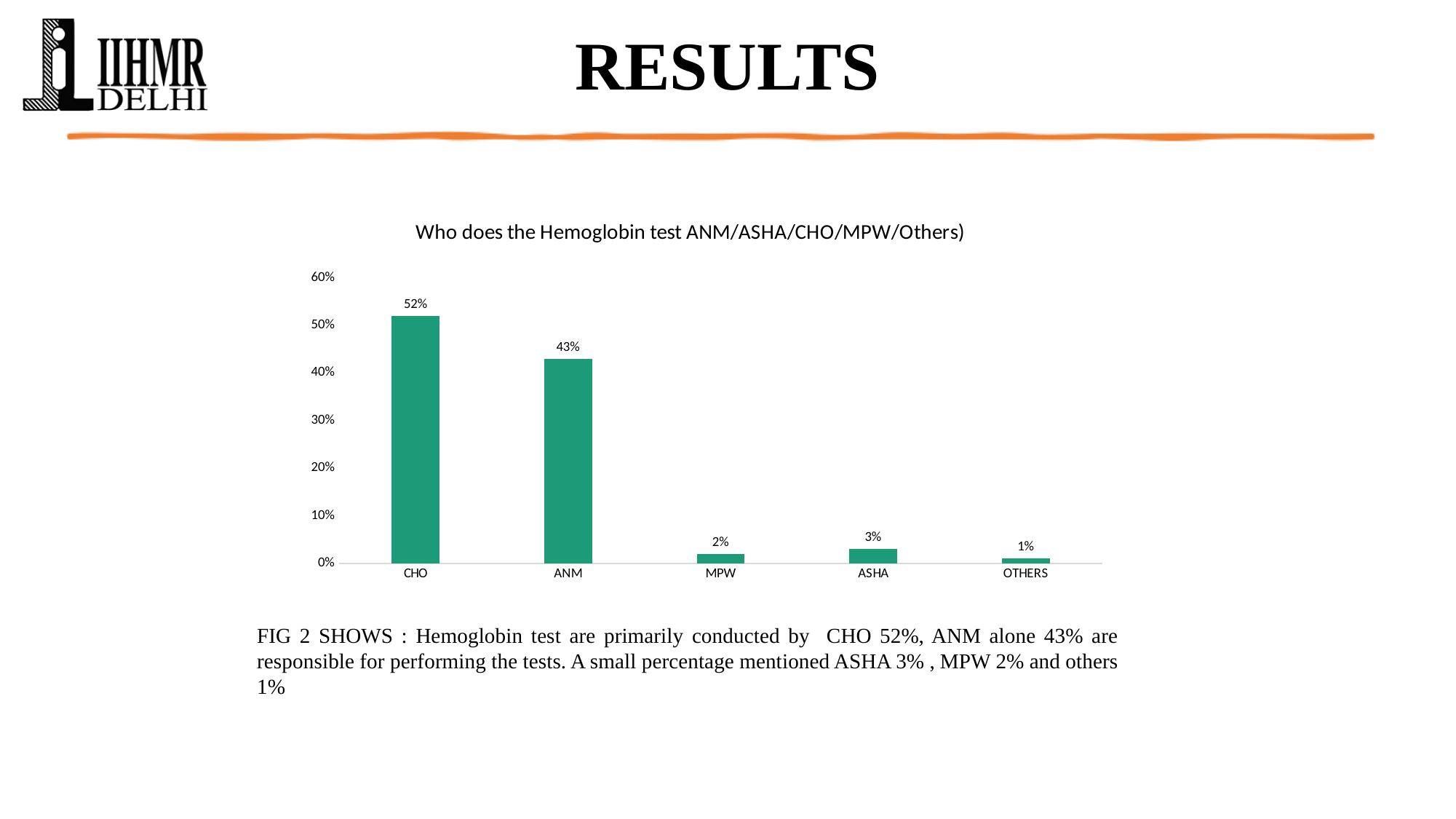
What is the value for CHO? 52% What is the value for OTHERS? 1% What is the title of the chart? Who does the Hemoglobin test ANM/ASHA/CHO/MPW/Others) What is the difference between the values for CHO and ANM? 9% What is the value for MPW? 2% What is the value for ANM? 43% Which category has the highest value? CHO What is the value for ASHA? 3% Which category has the lowest value? OTHERS How many categories are shown on the x axis? 5 What kind of chart is shown on the slide? Bar chart Which is larger, the value for ASHA or the value for MPW? ASHA